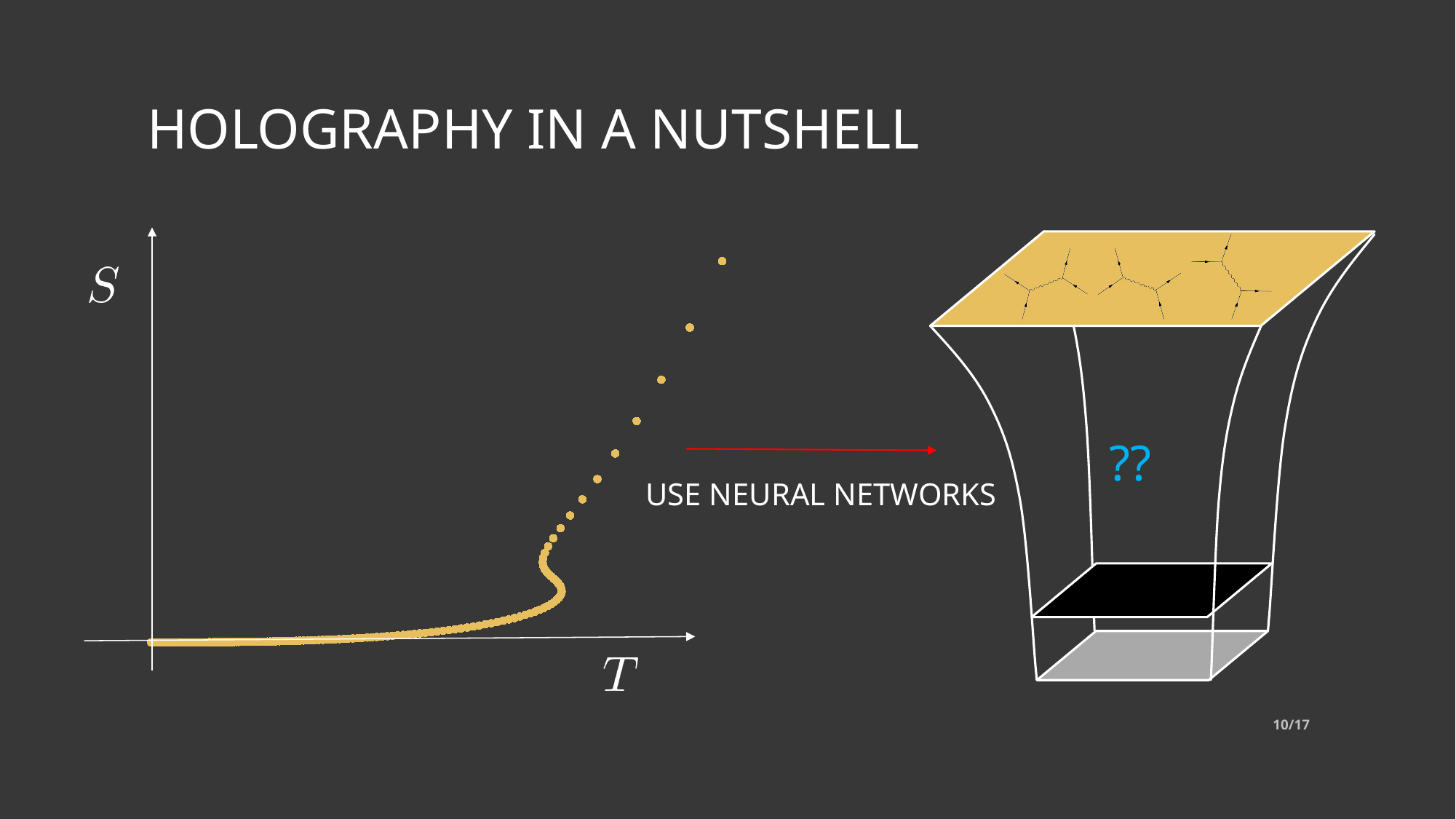
What is the label on the vertical axis of the chart? S Overall, do the plotted values of S rise or fall as T increases along the x axis? rise What kind of chart is shown on the left of the slide? scatter plot What is the label on the horizontal axis of the chart? T How many data series are plotted in the chart? 1